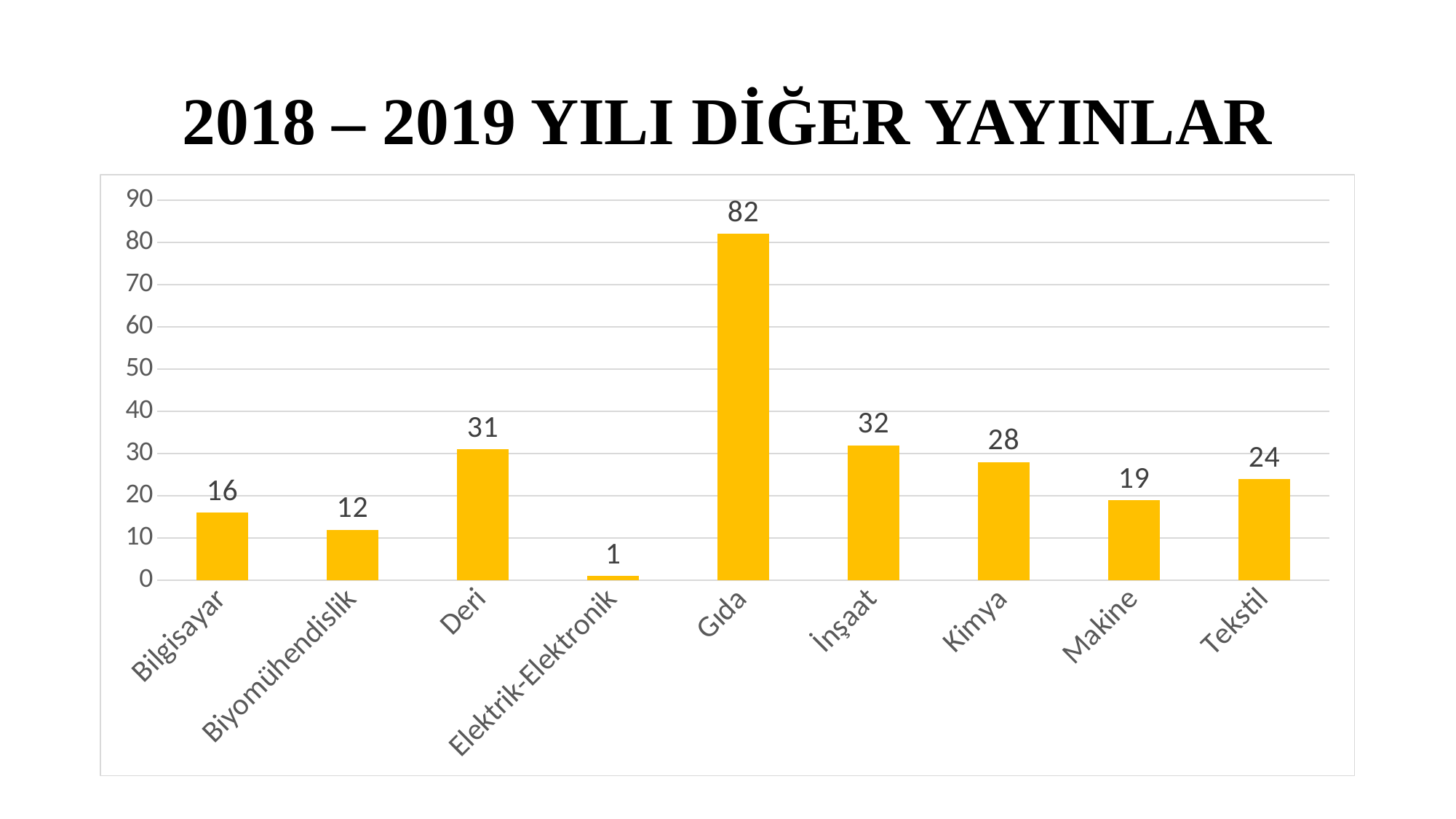
What kind of chart is shown on the slide? bar chart Which category has the lowest value? Elektrik-Elektronik Which category has the highest value? Gıda What is the title of the slide? 2018 – 2019 YILI DİĞER YAYINLAR Is the value for Deri greater or less than 20? greater How many categories are shown on the x axis? 9 What is the value for Biyomühendislik? 12 What is the value for Makine? 19 What is the difference between the values for Gıda and İnşaat? 50 What is the difference between the values for Deri and Bilgisayar? 15 What is the value for Gıda? 82 Which is larger, the value for Kimya or the value for Tekstil? Kimya